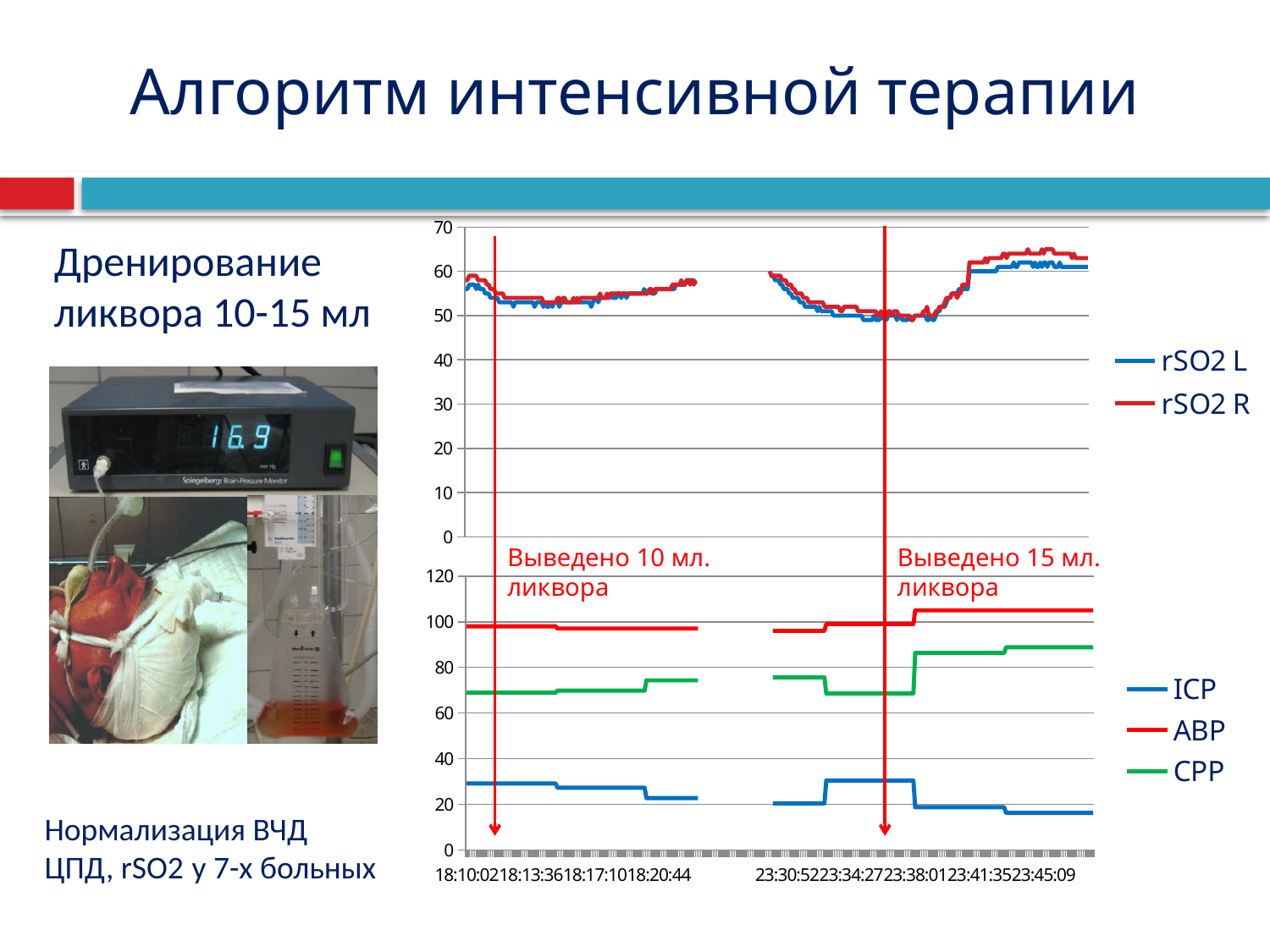
How many series does the legend of the top chart (rSO2) list? 2 In the bottom chart, does the CPP line rise or fall after the second red arrow (Выведено 15 мл. ликвора)? rise In the bottom chart, is the ABP line greater or less than 80 throughout? greater In the bottom chart, is the ICP line greater or less than 40 throughout? less How many series does the legend of the bottom chart (ICP, ABP, CPP) list? 3 In the top chart, are the rSO2 L values greater or less than 40 throughout? greater In the bottom chart, does the ICP line rise or fall after the second red arrow (Выведено 15 мл. ликвора)? fall What kind of chart is the bottom chart showing ICP, ABP and CPP? line chart In the top chart, which series is drawn in red? rSO2 R In the bottom chart, which series has the lowest values throughout the recording? ICP In the bottom chart, which series is drawn in green? CPP In the bottom chart, which series has the highest values throughout the recording? ABP